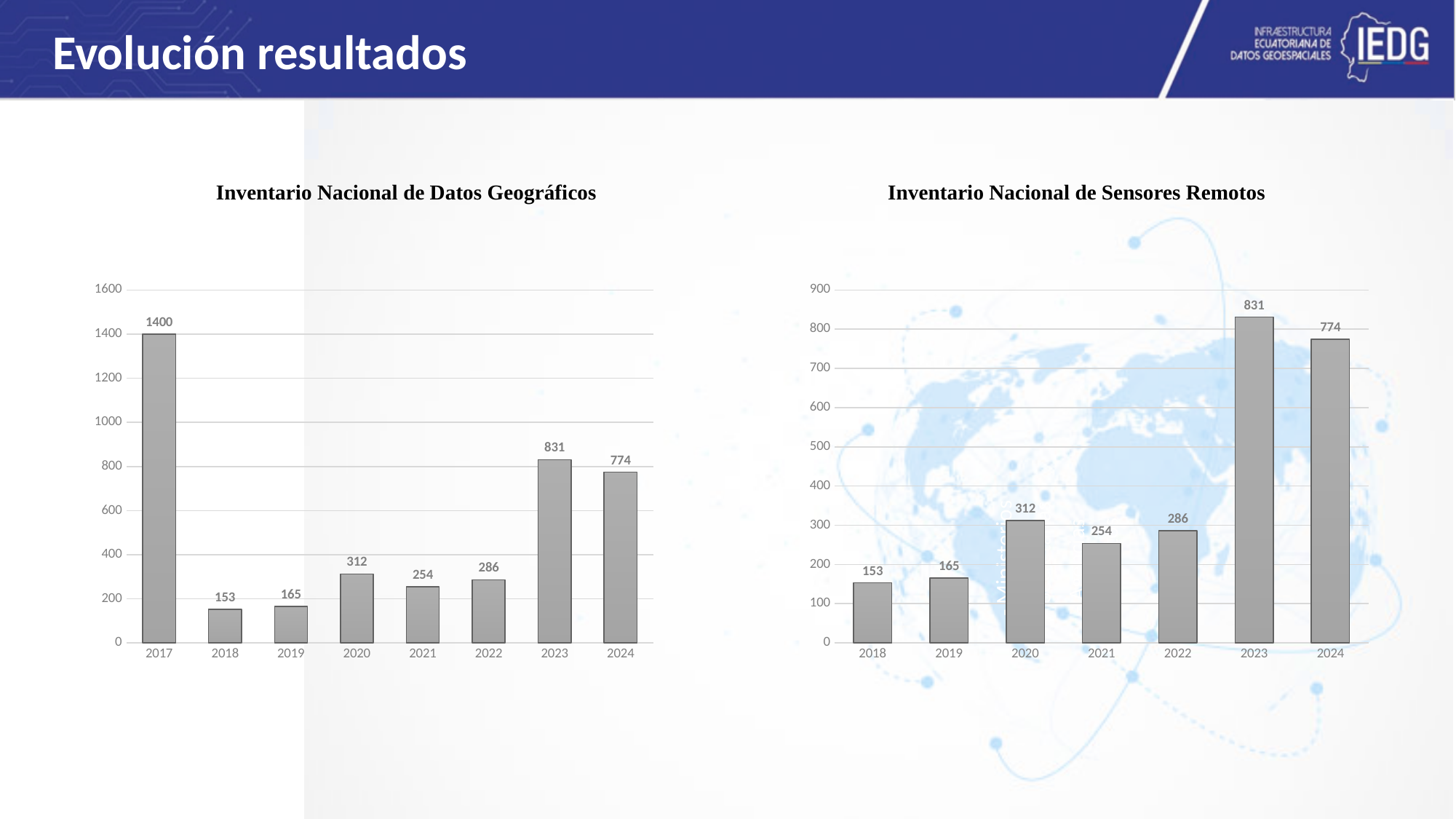
What kind of chart is the 'Inventario Nacional de Sensores Remotos' chart? Bar chart How many years are shown on the x axis of the 'Inventario Nacional de Sensores Remotos' chart? 7 In the 'Inventario Nacional de Sensores Remotos' chart, do the values rise or fall from 2018 to 2020? Rise In the 'Inventario Nacional de Sensores Remotos' chart, which is larger, the value for 2020 or the value for 2022? 2020 In the 'Inventario Nacional de Sensores Remotos' chart, which year has the highest value? 2023 In the 'Inventario Nacional de Datos Geográficos' chart, which year has the lowest value? 2018 What is the title of the chart on the left side of the slide? Inventario Nacional de Datos Geográficos How many years are shown on the x axis of the 'Inventario Nacional de Datos Geográficos' chart? 8 In the 'Inventario Nacional de Datos Geográficos' chart, what is the value for 2017? 1400 In the 'Inventario Nacional de Sensores Remotos' chart, what is the difference between the values for 2023 and 2024? 57 In the 'Inventario Nacional de Datos Geográficos' chart, what is the difference between the values for 2017 and 2023? 569 In the 'Inventario Nacional de Sensores Remotos' chart, what is the value for 2023? 831